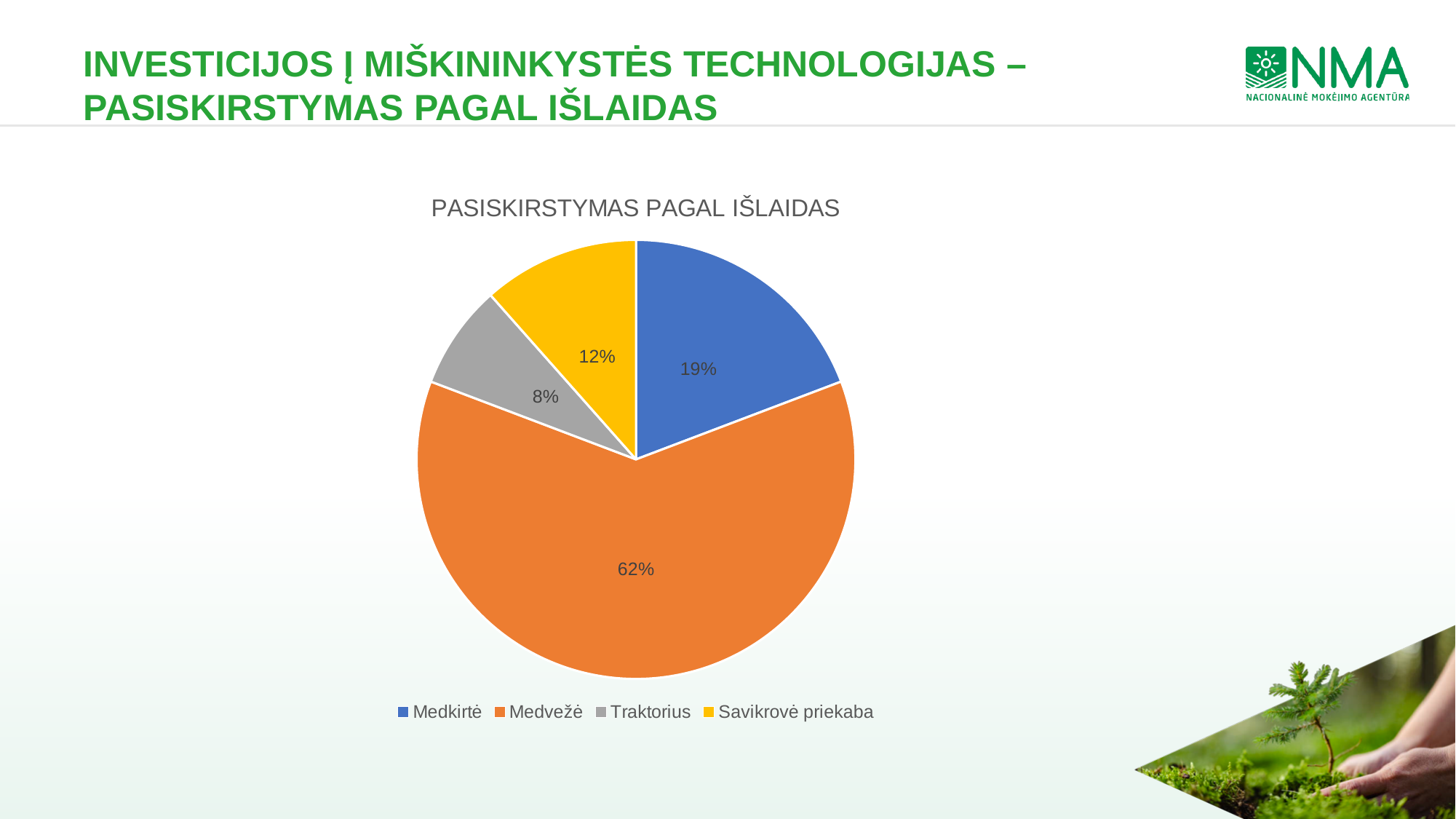
What is the title of the chart? PASISKIRSTYMAS PAGAL IŠLAIDAS How many categories does the pie chart show? 4 Which is larger, the share for Medkirtė or the share for Savikrovė priekaba? Medkirtė What is the difference in percentage points between the Medvežė share and the Medkirtė share? 43 percentage points Which category has the largest share of the pie? Medvežė What colour is the Savikrovė priekaba slice? Yellow What share of the pie does Medvežė account for? 62% What share of the pie does Traktorius account for? 8% What share of the pie does Savikrovė priekaba account for? 12% Which category has the smallest share of the pie? Traktorius What share of the pie does Medkirtė account for? 19% What type of chart is shown on the slide? Pie chart